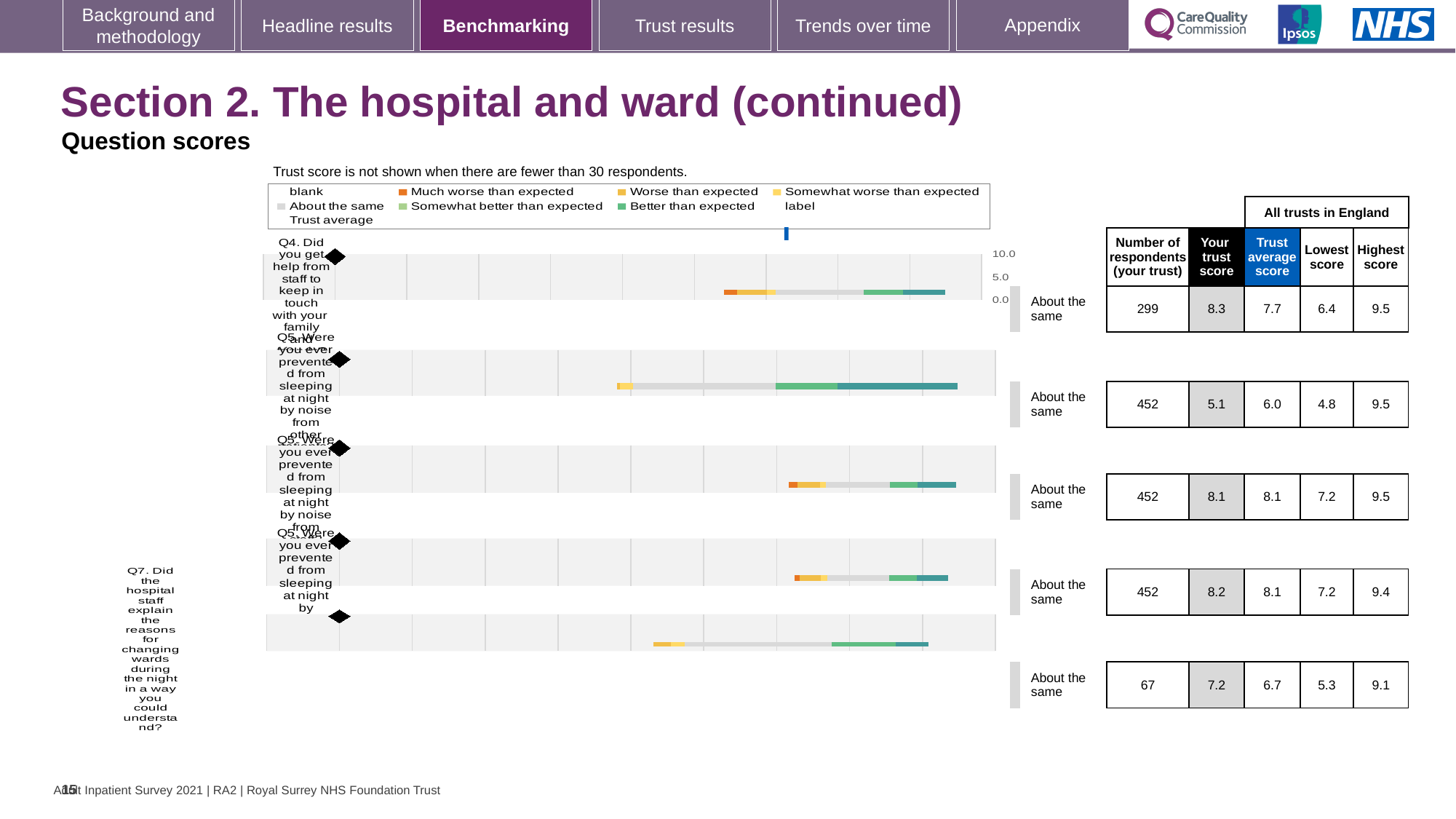
What kind of chart is used to show the question scores on this slide? bar chart How many question rows (bars) are plotted in the benchmarking chart? 5 For Q7 (the last row), what is the difference between the highest score and the lowest score? 3.8 What is the highest score across all trusts in England for Q4 (the first row)? 9.5 What is the trust average score for Q7 (the last row of the chart)? 6.7 Which question row has the fewest respondents? Q7 In the chart legend, which colour represents 'Much worse than expected'? orange For the second row of the chart, is 'Your trust score' (5.1) higher or lower than the trust average score (6.0)? lower For Q7 (the last row), is 'Your trust score' higher or lower than the trust average score? higher For Q4 (the first row), what is the difference between 'Your trust score' and the trust average score? 0.6 What is 'Your trust score' for Q7 (the last row of the chart)? 7.2 How many respondents does the table show for Q4 (the first row of the chart)? 299